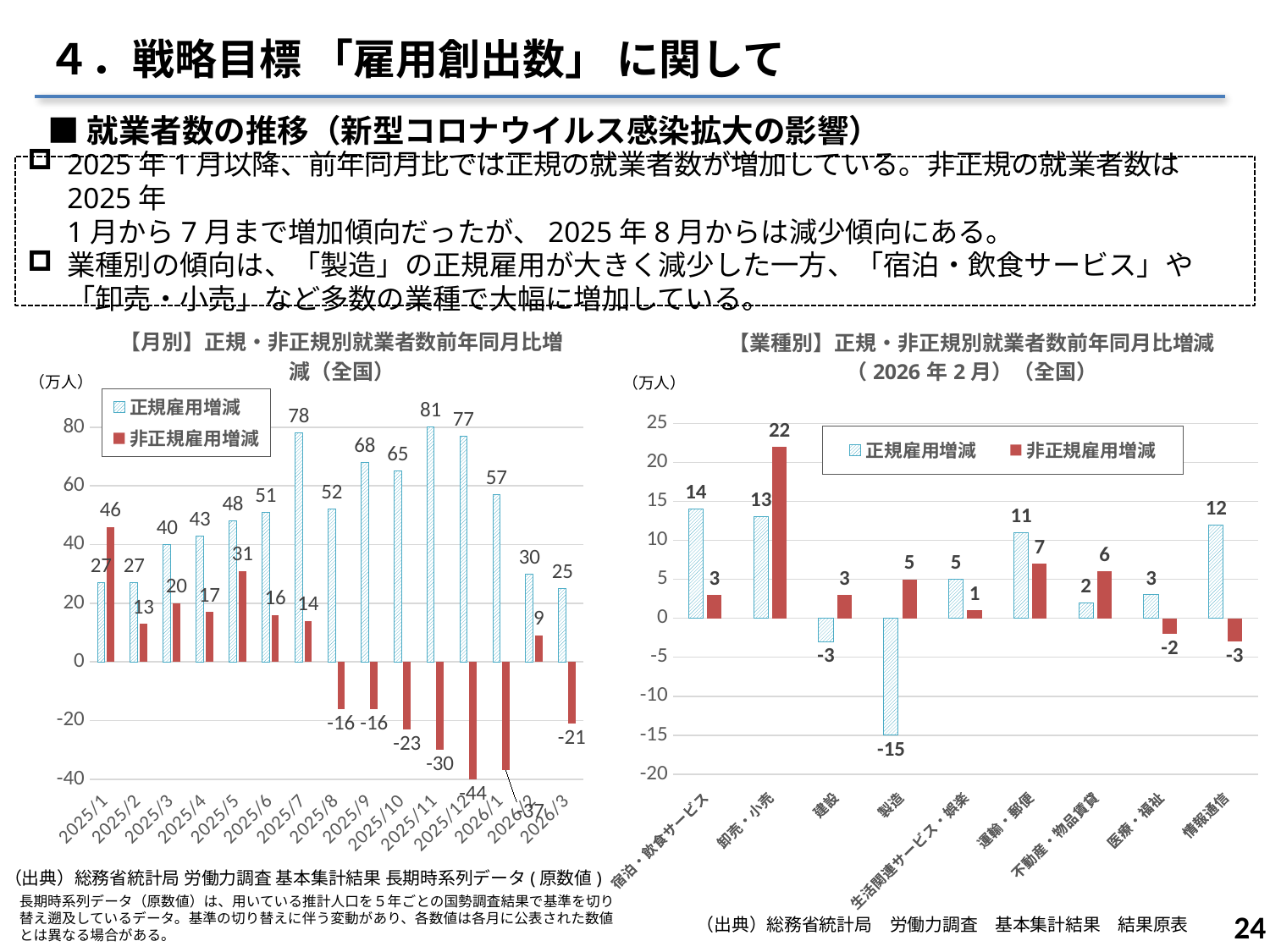
In the right chart (【業種別】), how many industries are shown? 9 What type of chart is the right chart (【業種別】)? bar chart In the left chart (【月別】), what is the difference between the 正規雇用増減 values for 2025/7 and 2025/8? 26 In the right chart (【業種別】), what is the difference between the 正規雇用増減 and 非正規雇用増減 values for 宿泊・飲食サービス? 11 In the right chart (【業種別】), which is larger for 情報通信: 正規雇用増減 or 非正規雇用増減? 正規雇用増減 In the left chart (【月別】), what is the value of 正規雇用増減 for 2025/11? 81 In the left chart (【月別】), how many months are shown on the x axis? 15 In the right chart (【業種別】), which industry has the lowest 正規雇用増減 value? 製造 In the left chart (【月別】), which month has the highest 正規雇用増減 value? 2025/11 In the left chart (【月別】), what is the value of 非正規雇用増減 for 2025/1? 46 In the right chart (【業種別】), what is the value of 非正規雇用増減 for 卸売・小売? 22 In the left chart (【月別】), is the 非正規雇用増減 value for 2025/12 greater or less than -40? less